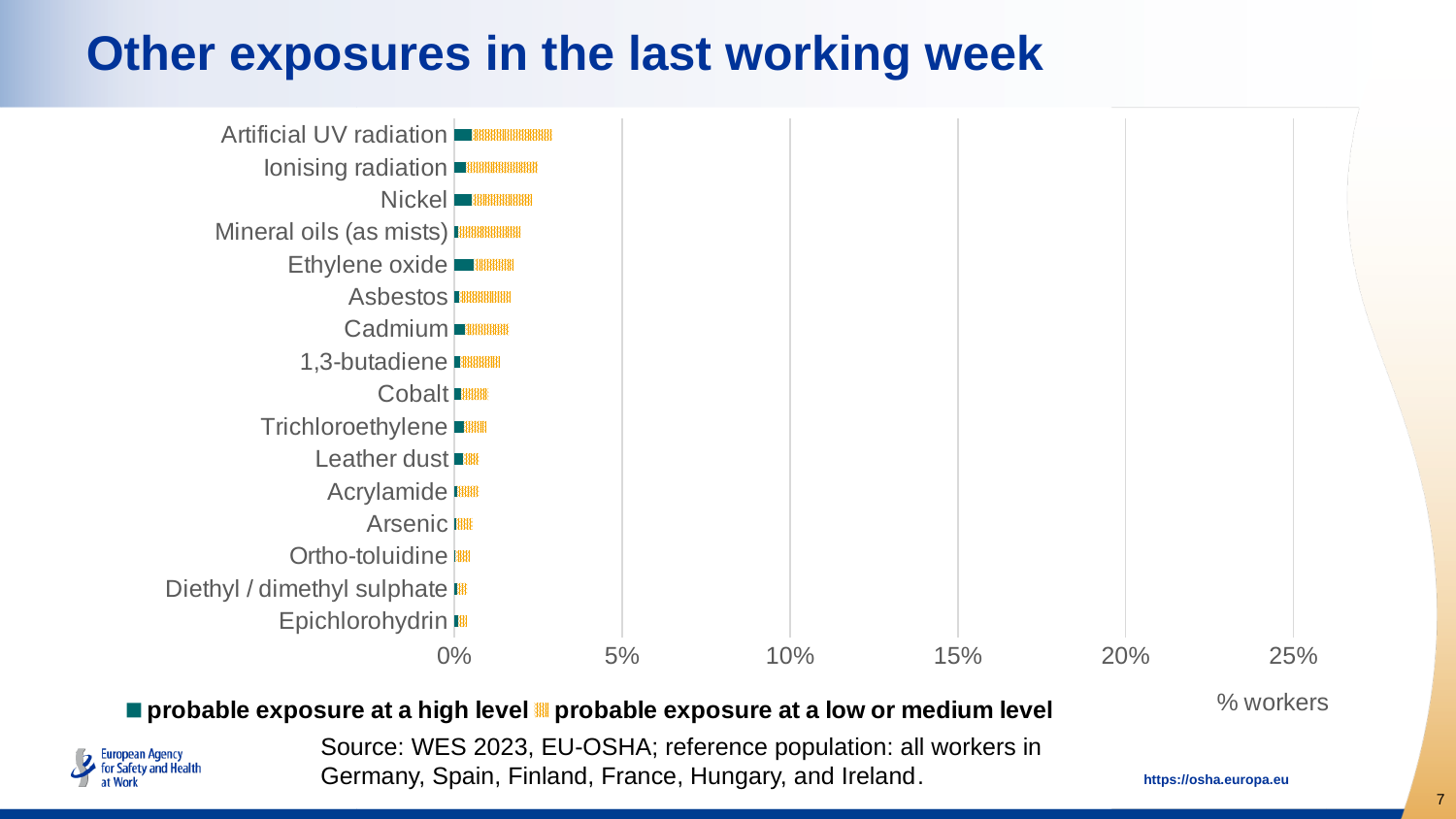
What is the highest value shown on the x axis? 25% Is the total bar for Nickel greater or less than 5%? less How many series does the legend list? 2 What kind of chart is shown on the slide? bar chart What unit is shown on the x axis of the chart? % workers How many exposure categories are listed on the chart? 16 What is the title of the slide containing the chart? Other exposures in the last working week Which has a longer bar, Artificial UV radiation or Cobalt? Artificial UV radiation Which exposure category has the longest bar? Artificial UV radiation Is the total bar for Artificial UV radiation greater or less than 5%? less Which exposure category has the shortest bar? Epichlorohydrin Which has a longer bar, Arsenic or Ionising radiation? Ionising radiation